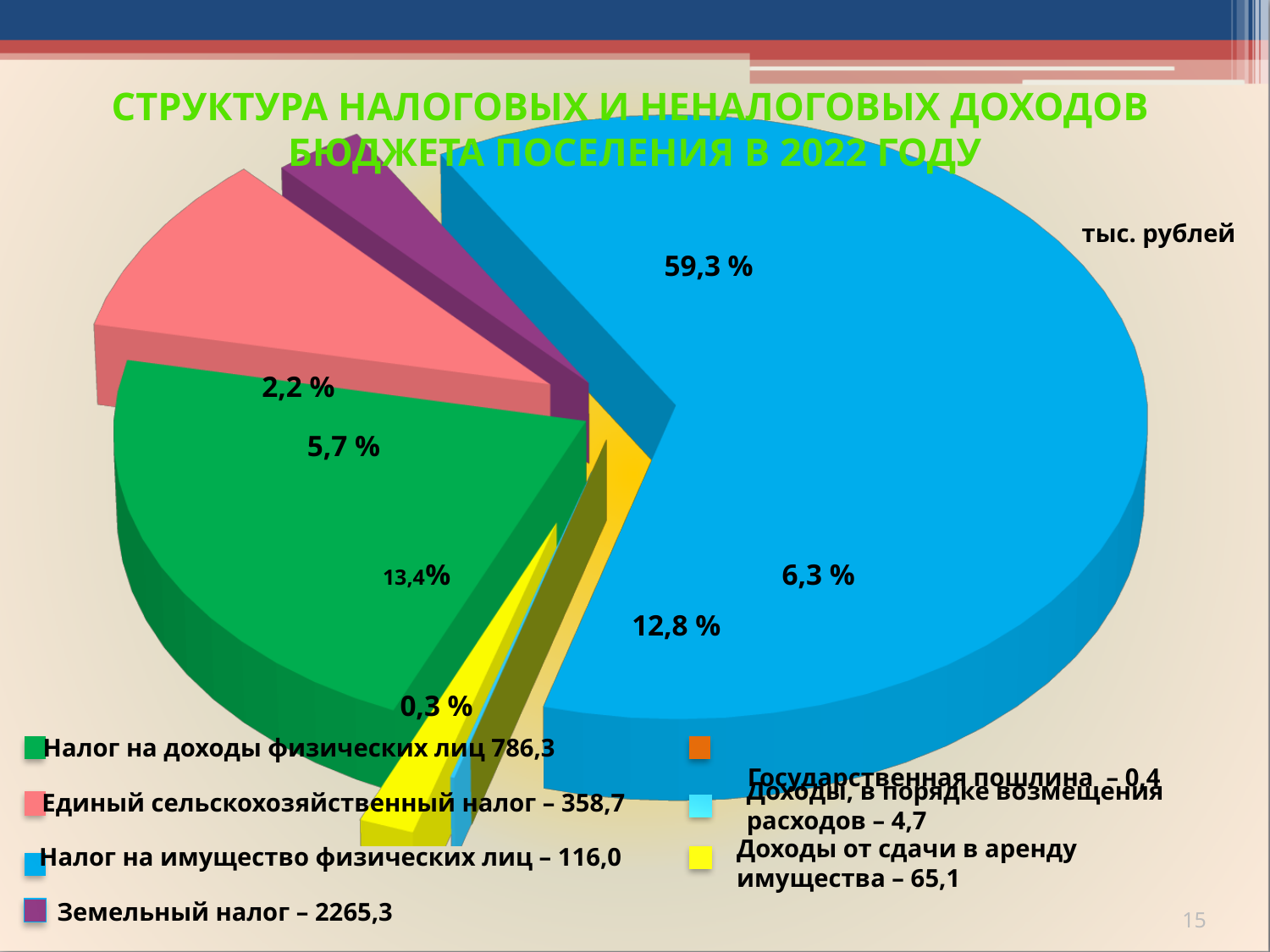
Which category has the largest value in the legend? Земельный налог Which category has the smallest value in the legend? Государственная пошлина What value is given in the legend for Земельный налог? 2265,3 Which is larger according to the legend: Налог на имущество физических лиц or Доходы от сдачи в аренду имущества? Налог на имущество физических лиц What is the difference between the legend values for Налог на доходы физических лиц and Единый сельскохозяйственный налог? 427,6 How many categories does the legend of the chart list? 7 What value is given in the legend for Единый сельскохозяйственный налог? 358,7 What is the largest percentage label printed on the pie chart? 59,3 % What value is given in the legend for Доходы от сдачи в аренду имущества? 65,1 What is the title of the chart on the slide? СТРУКТУРА НАЛОГОВЫХ И НЕНАЛОГОВЫХ ДОХОДОВ БЮДЖЕТА ПОСЕЛЕНИЯ В 2022 ГОДУ What kind of chart is shown on the slide? pie chart What value is given in the legend for Налог на доходы физических лиц? 786,3